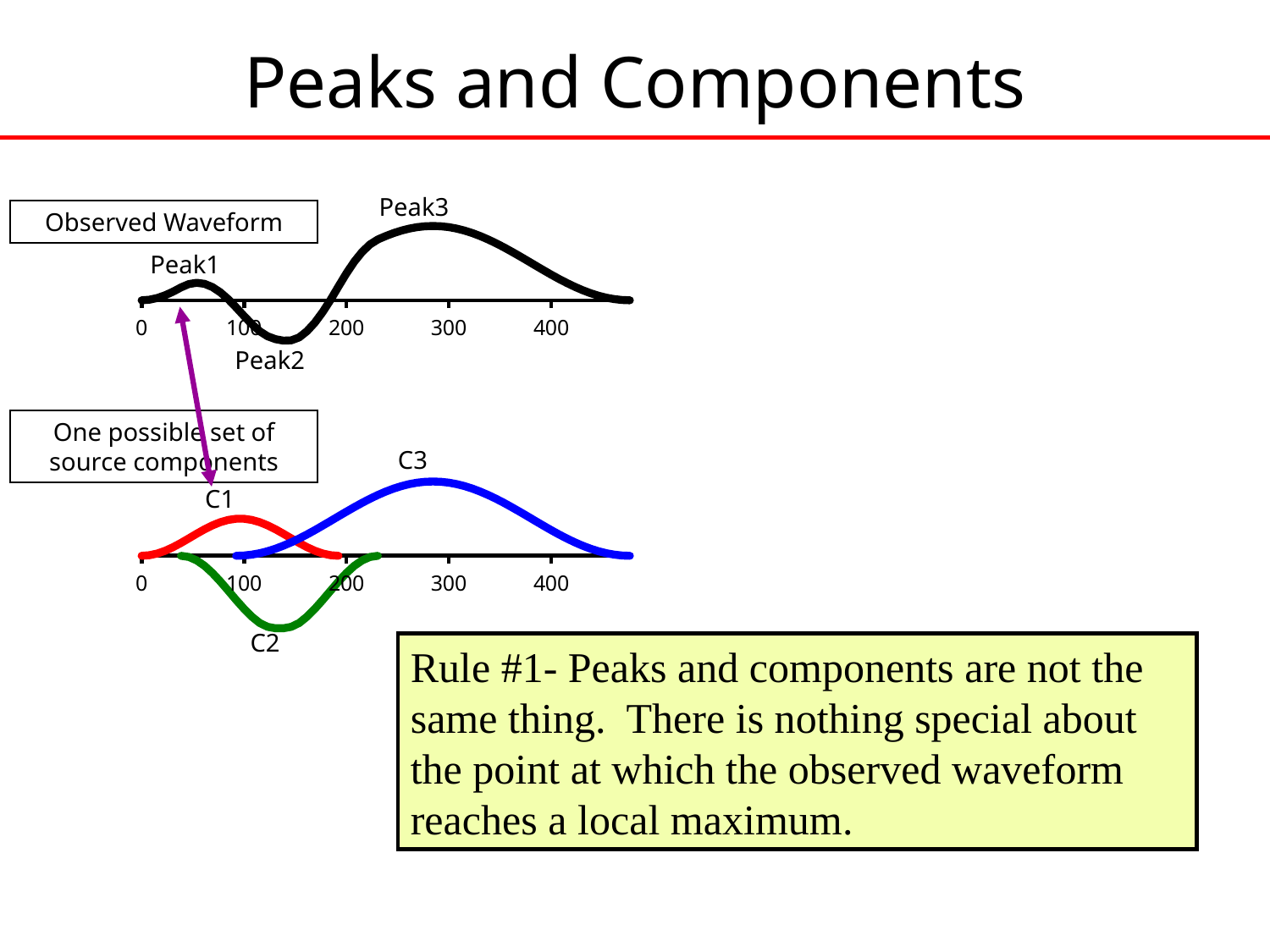
On the Observed Waveform chart, which labelled peak is the lowest (dips below the axis)? Peak2 On the bottom chart (One possible set of source components), which component goes below the axis? C2 On the bottom chart (One possible set of source components), what colour is component C3 drawn in? blue On the Observed Waveform chart, which is larger, Peak1 or Peak3? Peak3 What kind of chart is the Observed Waveform chart? line chart On the Observed Waveform chart, is the x position of Peak1's maximum greater or less than 100? less On the Observed Waveform chart, which labelled peak reaches the highest value? Peak3 On the bottom chart (One possible set of source components), is the x position of C3's maximum greater or less than 200? greater How many peaks are labelled on the Observed Waveform chart? 3 On the Observed Waveform chart, is the x position of Peak3's maximum greater or less than 200? greater How many source components are labelled on the bottom chart (One possible set of source components)? 3